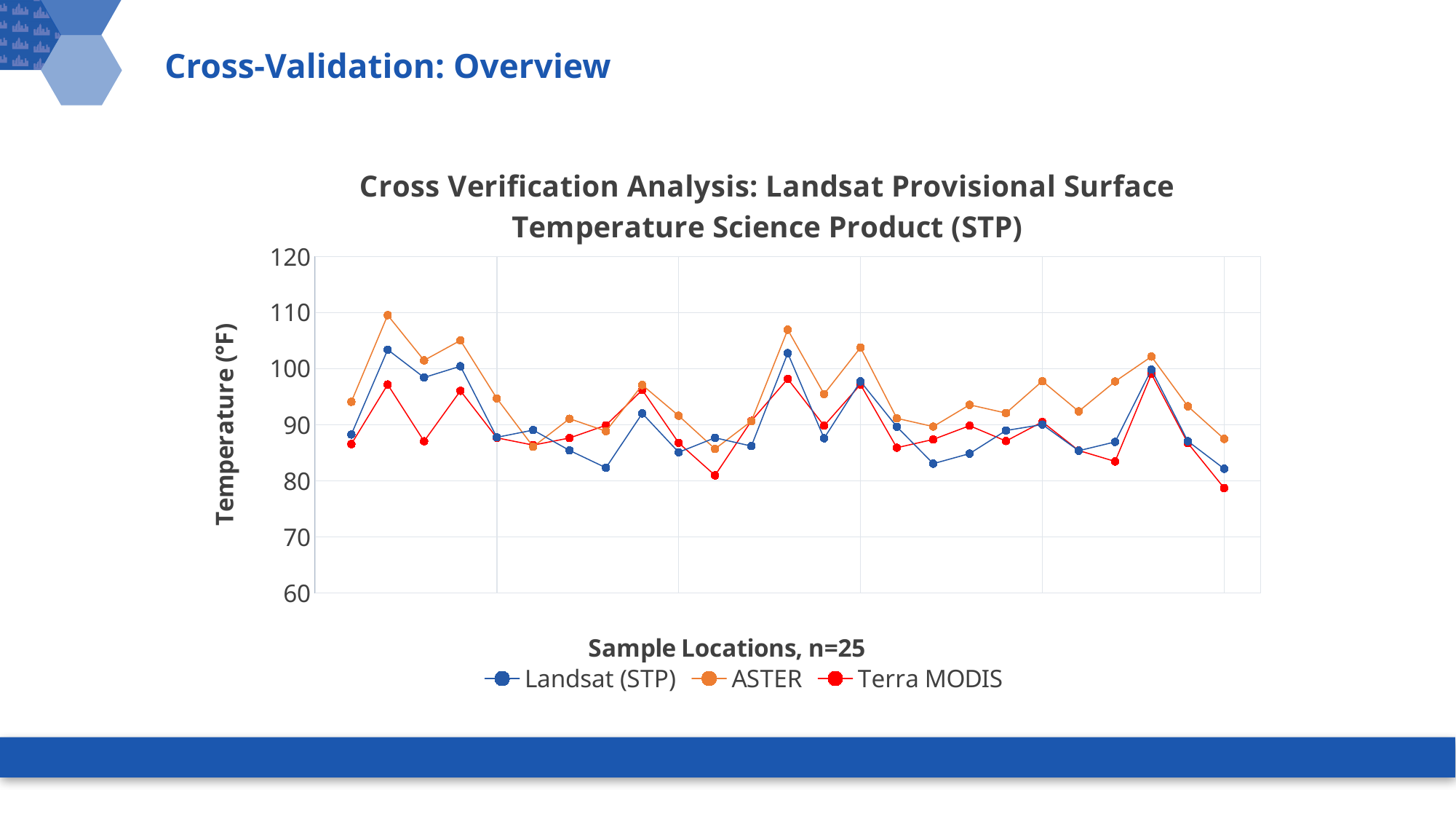
Is the Landsat (STP) value at the last sample location greater or less than 90? less Is the highest ASTER value greater or less than 100? greater What is the label of the y axis? Temperature (°F) At the first sample location, which is larger: the ASTER value or the Terra MODIS value? ASTER Which series reaches the lowest temperature value on the chart? Terra MODIS What kind of chart is shown on the slide? Line chart How many sample locations are plotted along the x axis? 25 Does the ASTER line end higher or lower than it starts? lower Is the Terra MODIS value at the first sample location greater or less than 90? less Which series reaches the highest temperature value on the chart? ASTER What are the three series named in the legend? Landsat (STP), ASTER, Terra MODIS How many series does the legend list? 3